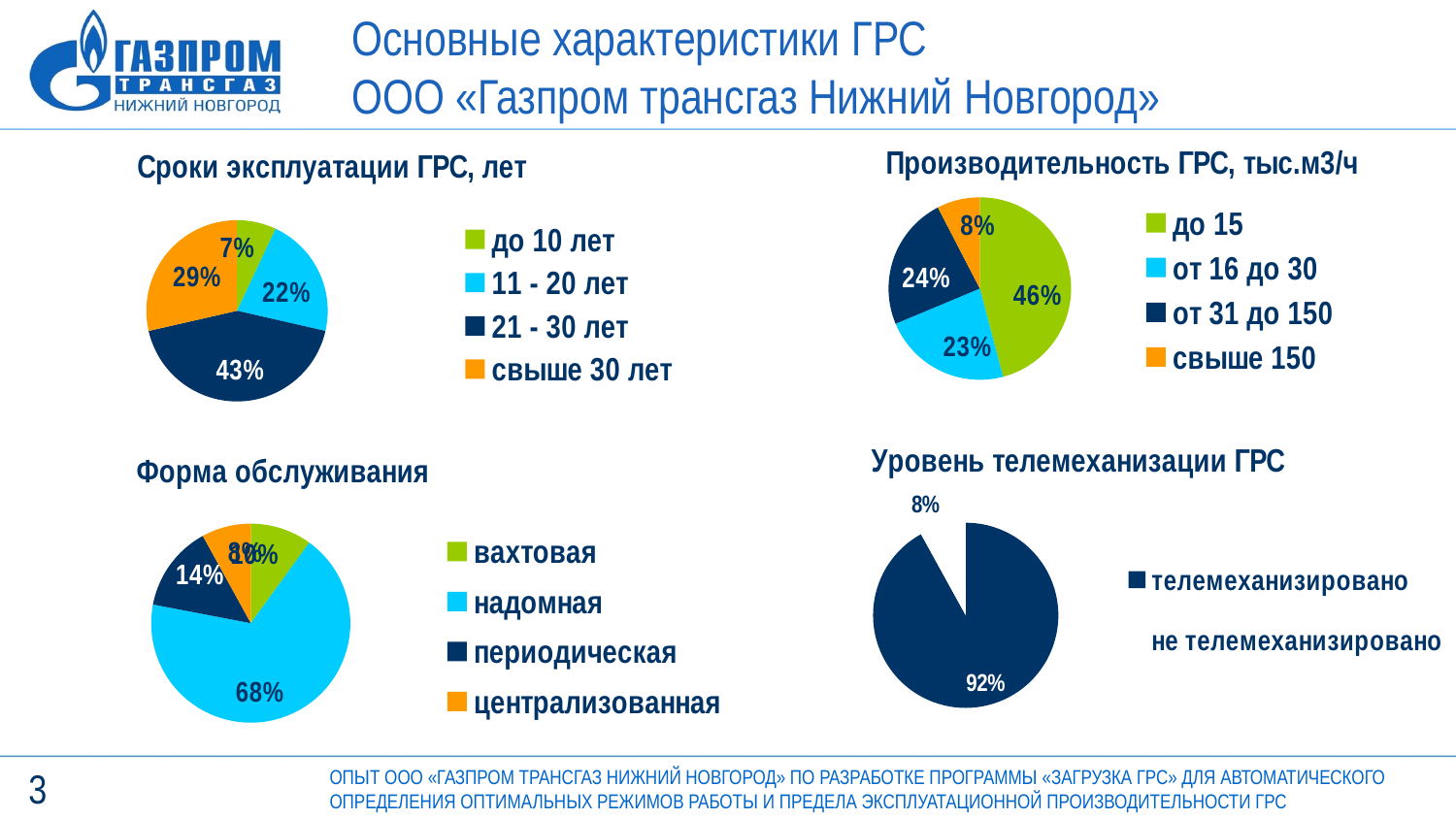
In the chart titled «Производительность ГРС, тыс.м3/ч», which category has the largest share? до 15 In the chart titled «Сроки эксплуатации ГРС, лет», which category has the smallest share? до 10 лет In the chart titled «Сроки эксплуатации ГРС, лет», what is the difference between the shares for «21 - 30 лет» and «11 - 20 лет»? 21% In the chart titled «Сроки эксплуатации ГРС, лет», what share is shown for «свыше 30 лет»? 29% In the chart titled «Сроки эксплуатации ГРС, лет», what share is shown for «21 - 30 лет»? 43% In the chart titled «Производительность ГРС, тыс.м3/ч», what share is shown for «до 15»? 46% In the chart titled «Уровень телемеханизации ГРС», what share is shown for «телемеханизировано»? 92% What type of chart is used for «Уровень телемеханизации ГРС»? Pie chart In the chart titled «Форма обслуживания», which is larger: the share for «надомная» or the share for «периодическая»? надомная In the chart titled «Производительность ГРС, тыс.м3/ч», how many categories does the legend list? 4 In the chart titled «Производительность ГРС, тыс.м3/ч», what share is shown for «свыше 150»? 8% In the chart titled «Форма обслуживания», what share is shown for «надомная»? 68%